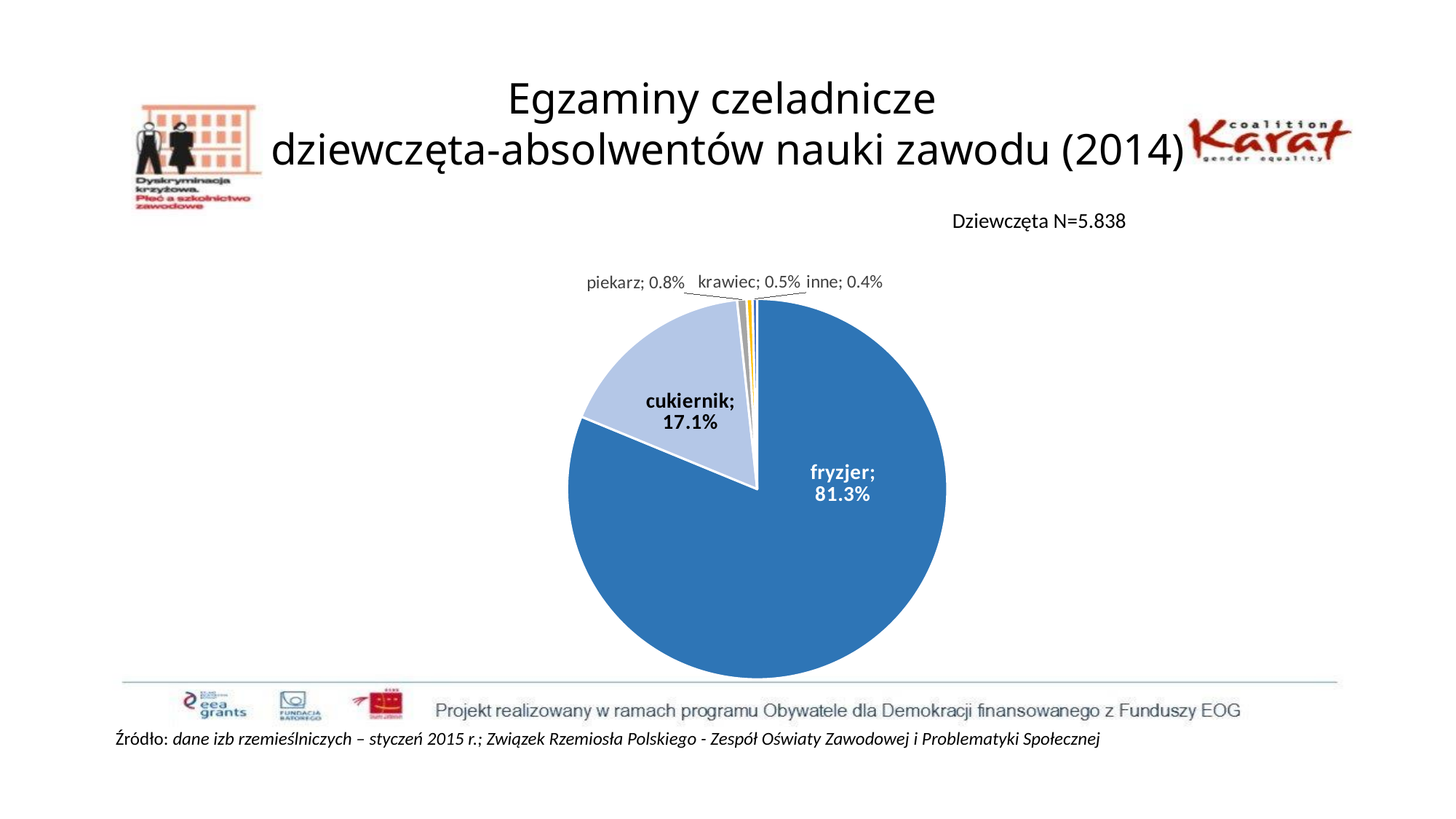
Which category has the smallest share of the pie? inne What share of the pie does cukiernik have? 17.1% What is the sample size (N) for girls stated on the slide? N=5.838 What is the value for krawiec? 0.5% What kind of chart is shown on the slide? pie chart Which is larger, the share for piekarz or the share for krawiec? piekarz Which category has the largest share of the pie? fryzjer What is the difference between the shares of fryzjer and cukiernik? 64.2% How many categories are shown in the pie chart? 5 What is the value for inne? 0.4% What share of the pie does fryzjer have? 81.3% What is the value for piekarz? 0.8%